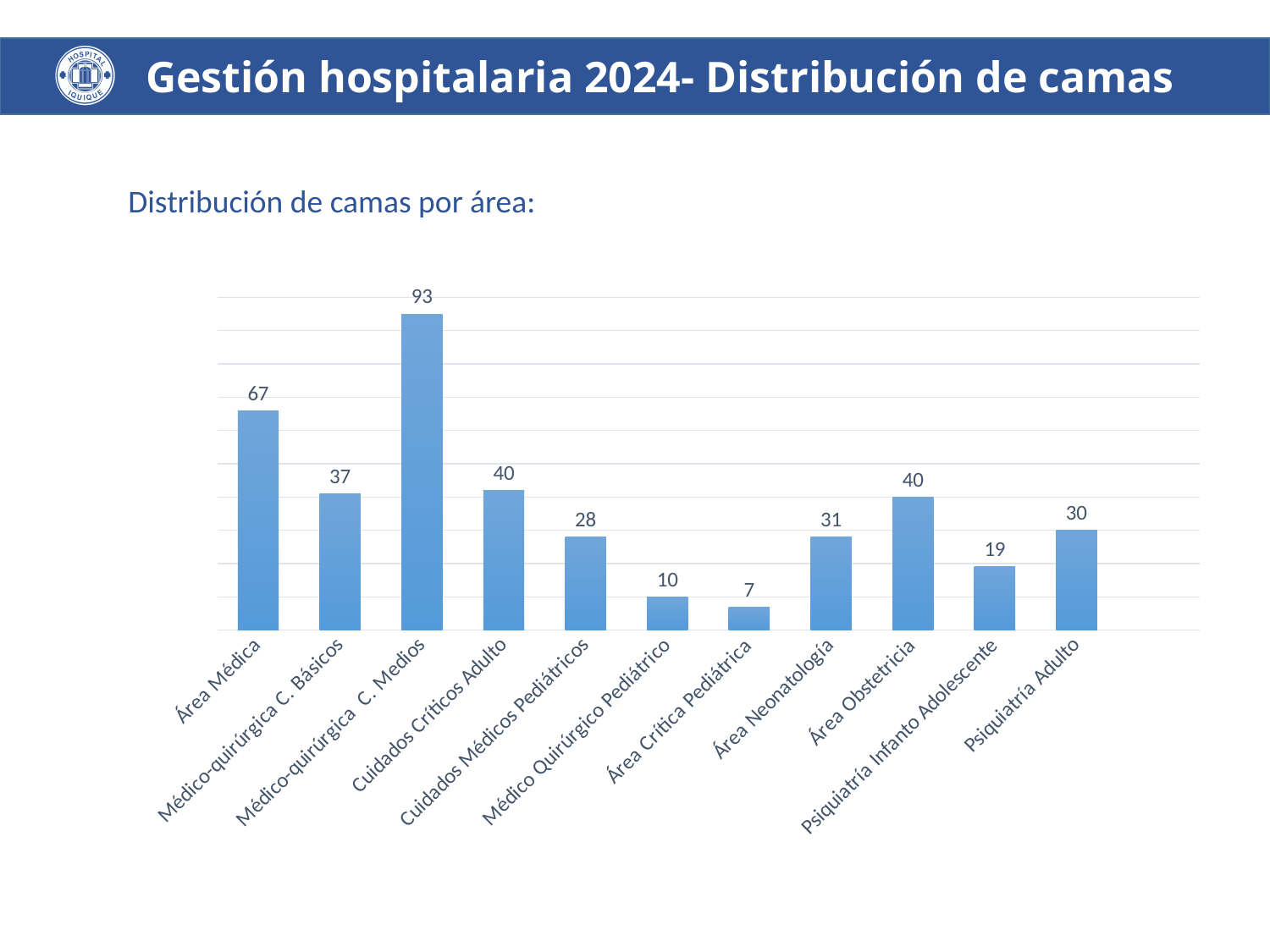
What is the value for Médico-quirúrgica C. Medios? 93 What is the value for Psiquiatría Infanto Adolescente? 19 What kind of chart is shown on the slide? Bar chart What is the difference between Área Médica and Médico-quirúrgica C. Básicos? 30 How many areas are shown on the chart? 11 Which area has the highest number of beds? Médico-quirúrgica C. Medios What is the difference between Médico-quirúrgica C. Medios and Cuidados Críticos Adulto? 53 What is the heading above the chart? Distribución de camas por área: How many beds does Área Médica have? 67 Which area has the lowest number of beds? Área Crítica Pediátrica Which is larger, Cuidados Médicos Pediátricos or Médico Quirúrgico Pediátrico? Cuidados Médicos Pediátricos